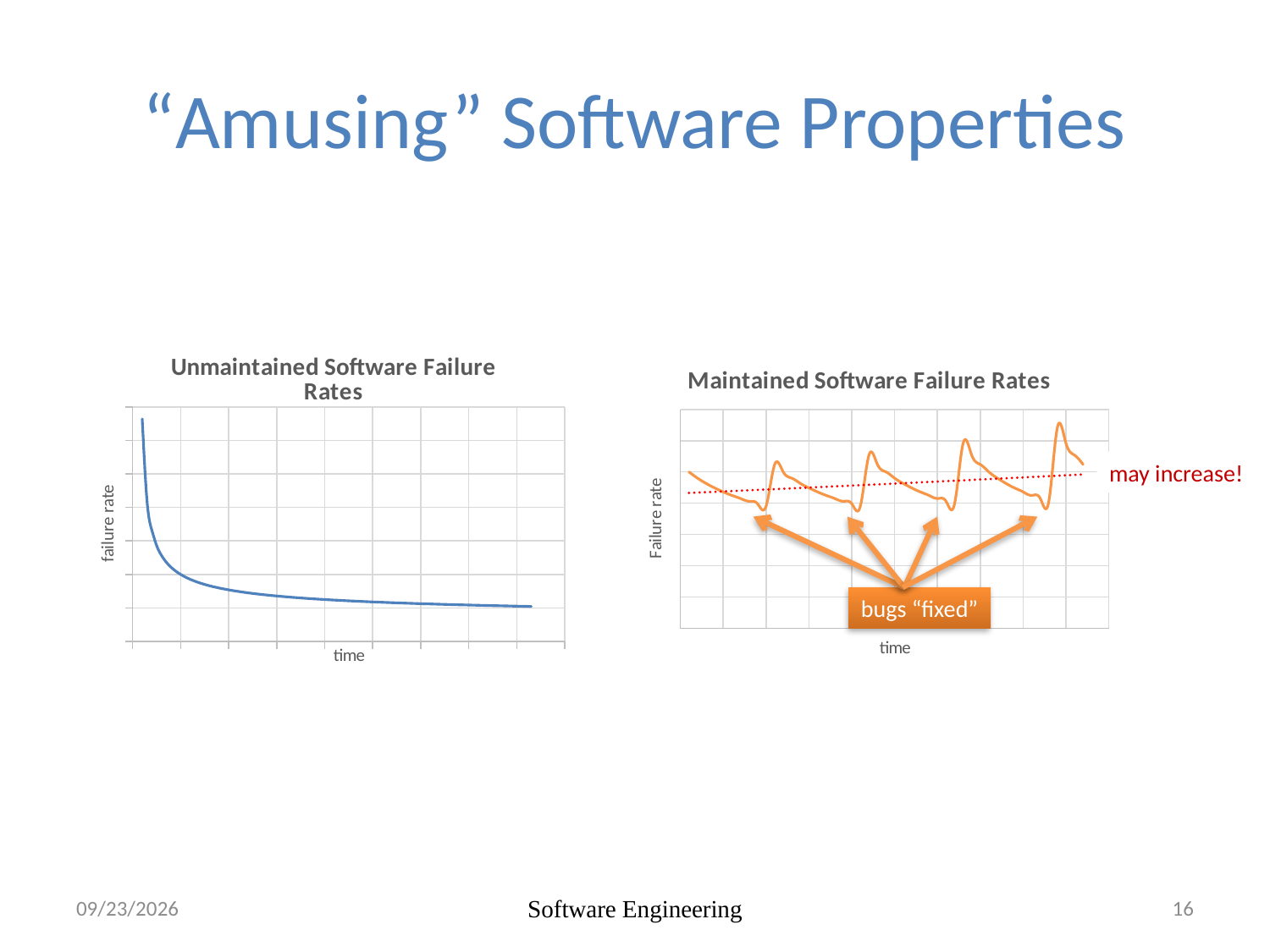
What is the label on the x axis of the "Maintained Software Failure Rates" chart? time In the "Unmaintained Software Failure Rates" chart, does the failure rate rise or fall over time? Fall In the "Maintained Software Failure Rates" chart, how many points does the "bugs "fixed"" label point to with arrows? 4 What kind of chart is the "Maintained Software Failure Rates" chart on the right? Line chart What is the title of the chart on the left of the slide? Unmaintained Software Failure Rates In the "Maintained Software Failure Rates" chart, does the dotted red trend line rise or fall over time? Rise What kind of chart is the "Unmaintained Software Failure Rates" chart on the left? Line chart